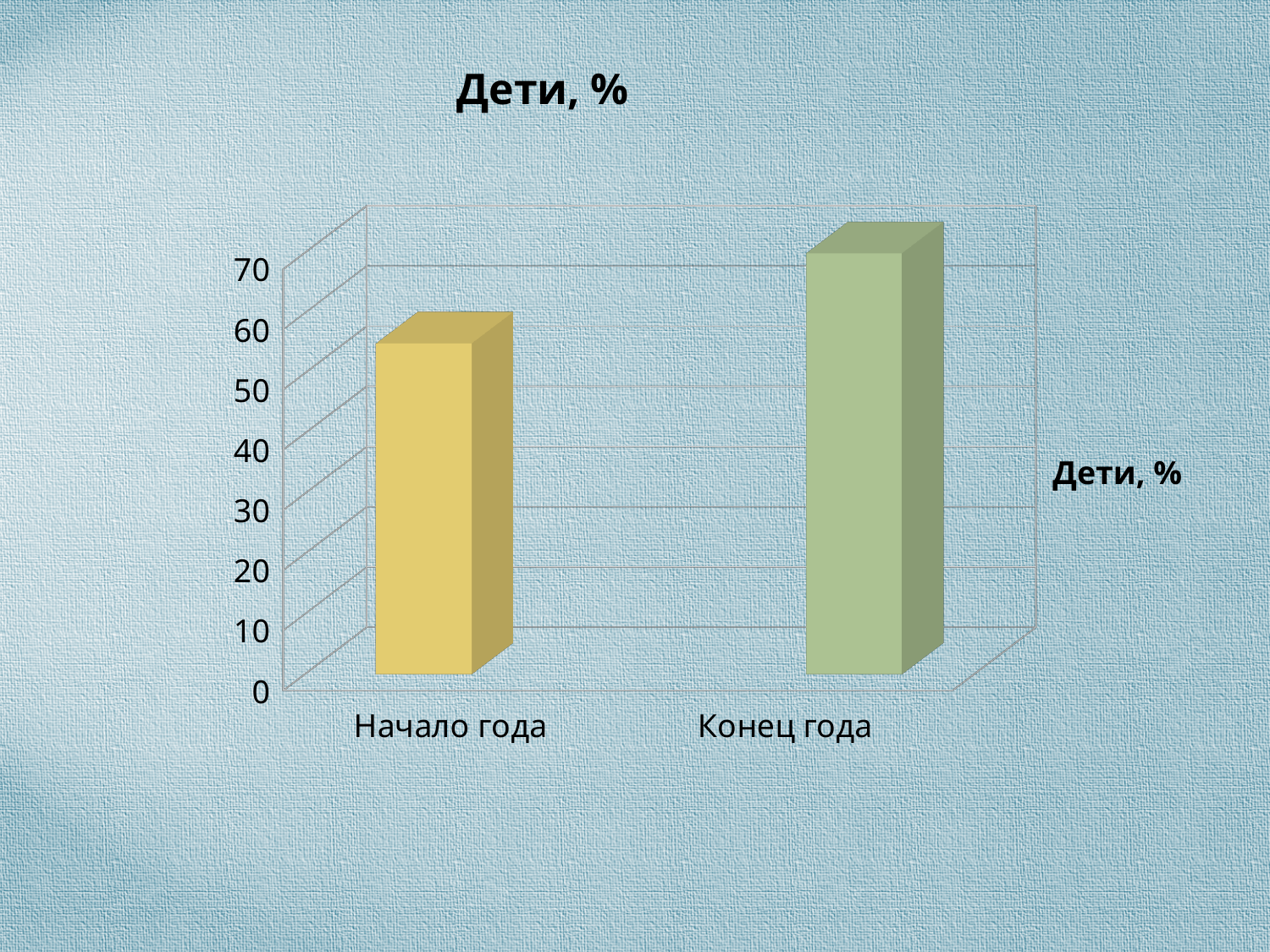
Is the value for Конец года greater or less than 60? greater Do the values rise or fall from Начало года to Конец года? rise Which category has the highest bar? Конец года What kind of chart is shown on the slide? bar chart Is the value for Начало года greater or less than 40? greater Which is larger, the value for Начало года or the value for Конец года? Конец года Which category has the lowest bar? Начало года How many categories are shown on the x axis of the chart? 2 What is the title of the chart? Дети, %